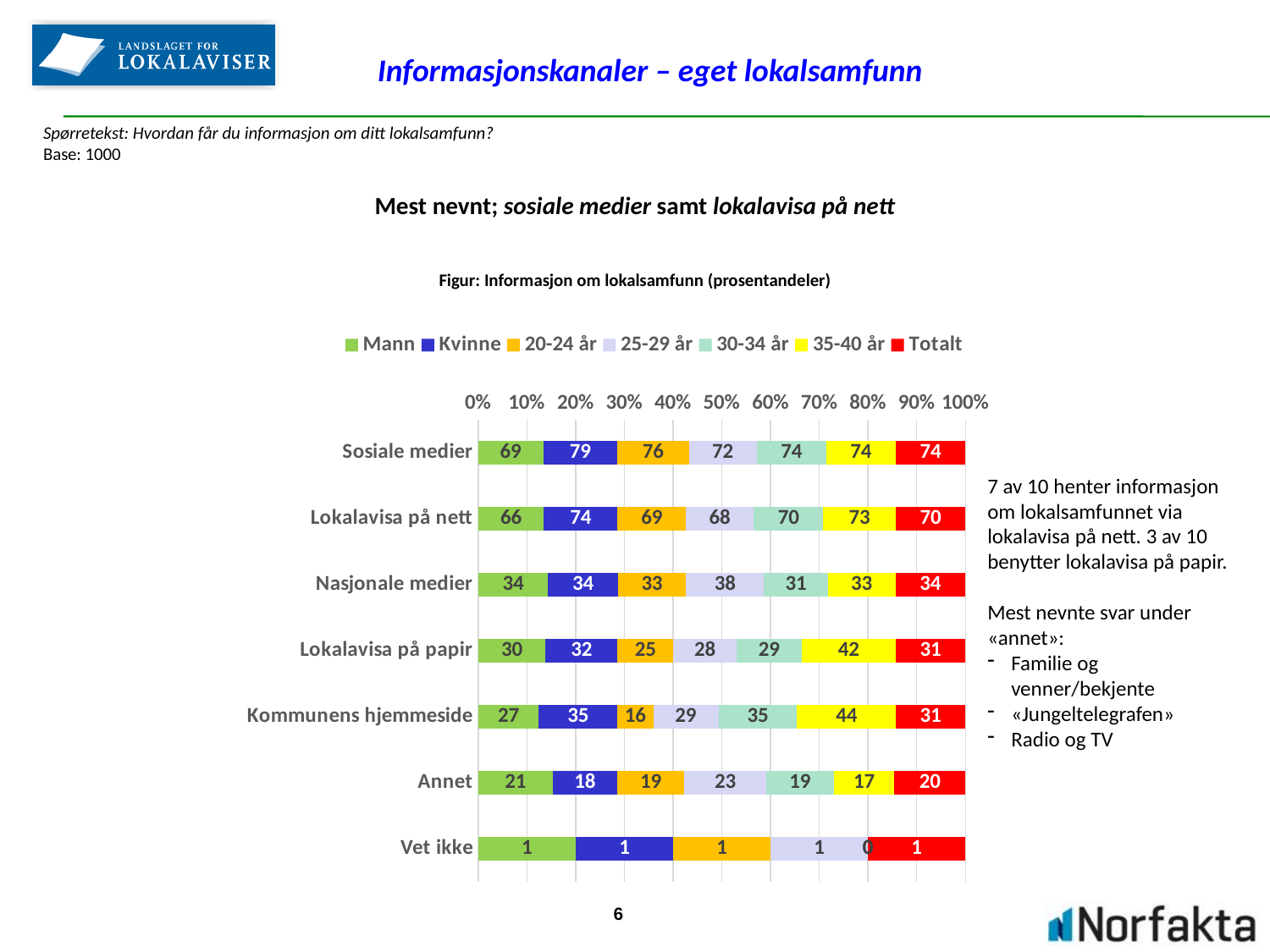
What is the Totalt value for Sosiale medier? 74 What is the 20-24 år value for Lokalavisa på papir? 25 What is the 25-29 år value for Annet? 23 Which category has the lowest Totalt value? Vet ikke For Kommunens hjemmeside, how much larger is the 35-40 år value than the 20-24 år value? 28 For Sosiale medier, what is the difference between the Kvinne value and the Mann value? 10 How many series does the legend list? 7 For Lokalavisa på papir, which is larger: the 35-40 år value or the Mann value? 35-40 år What is the 35-40 år value for Kommunens hjemmeside? 44 Which category has the highest Totalt value? Sosiale medier What kind of chart is shown on the slide? Stacked bar chart What is the Kvinne value for Lokalavisa på nett? 74